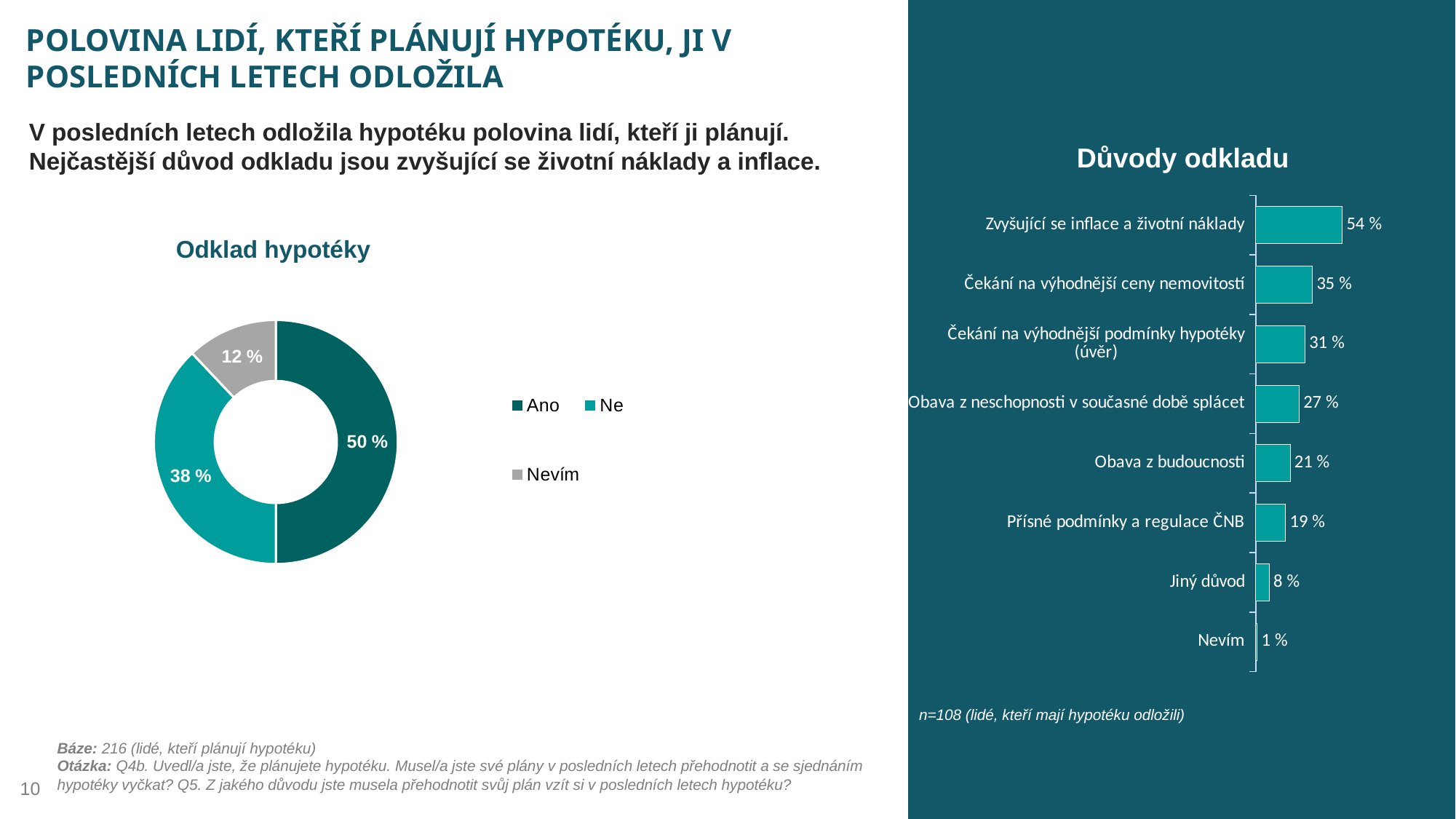
In the 'Odklad hypotéky' chart, what share is labelled for 'Ano'? 50 % How many categories are shown in the 'Důvody odkladu' chart? 8 In the 'Odklad hypotéky' chart, which category has the smallest slice? Nevím In the 'Důvody odkladu' chart, what is the difference between 'Zvyšující se inflace a životní náklady' and 'Obava z budoucnosti'? 33 % In the 'Důvody odkladu' chart, what is the value for 'Čekání na výhodnější ceny nemovitostí'? 35 % In the 'Důvody odkladu' chart, which reason has the lowest value? Nevím What kind of chart is 'Odklad hypotéky'? Doughnut (pie) chart How many entries does the legend of the 'Odklad hypotéky' chart list? 3 In the 'Důvody odkladu' chart, what is the value for 'Přísné podmínky a regulace ČNB'? 19 % In the 'Odklad hypotéky' chart, what is the difference between the 'Ano' and 'Ne' shares? 12 % In the 'Důvody odkladu' chart, which reason has the highest value? Zvyšující se inflace a životní náklady In the 'Odklad hypotéky' chart, what share is labelled for 'Nevím'? 12 %